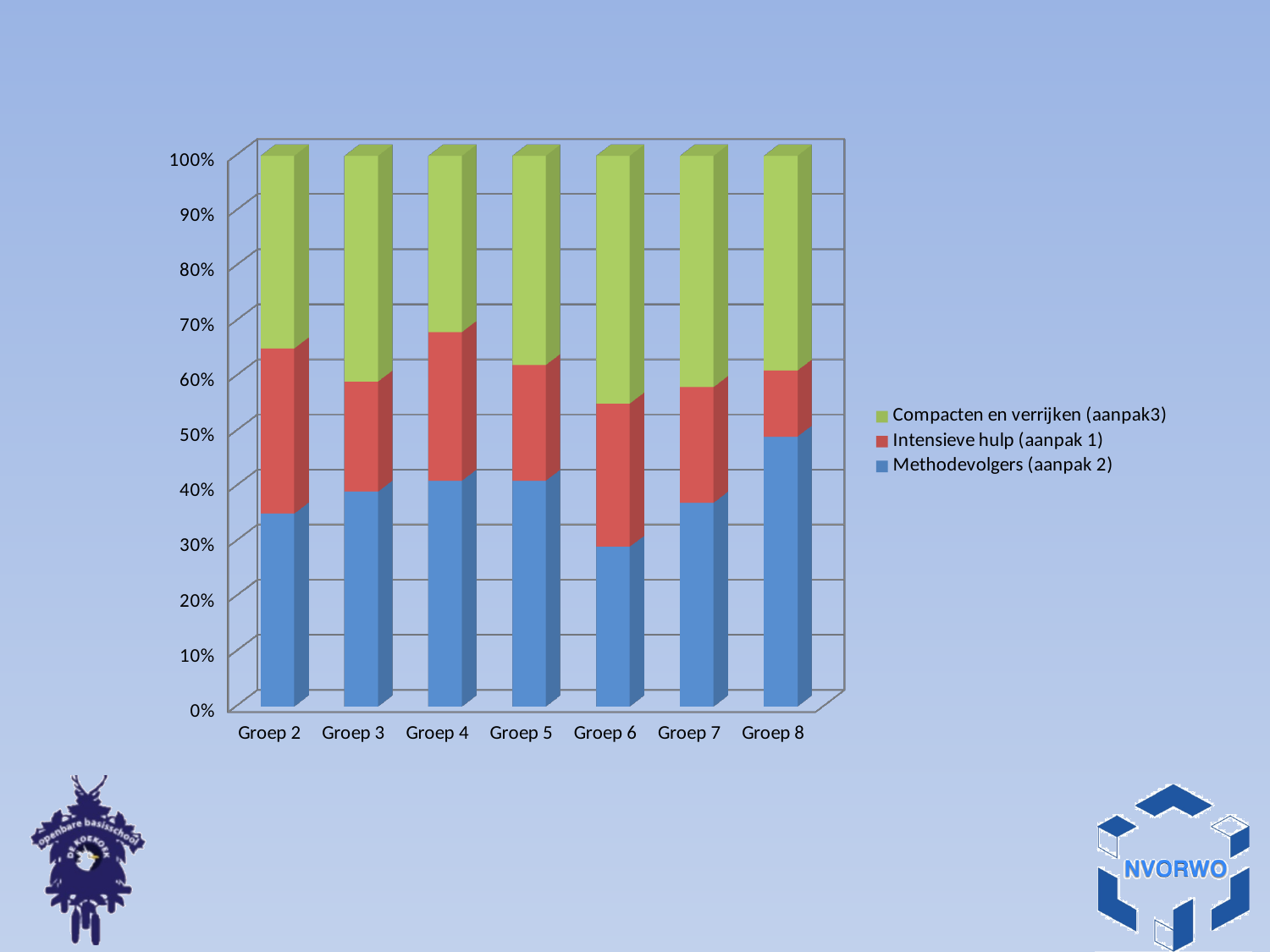
How many series does the legend list? 3 Which colour represents Methodevolgers (aanpak 2)? Blue Which group has the largest share for Methodevolgers (aanpak 2)? Groep 8 Which is larger: the Methodevolgers (aanpak 2) share in Groep 4 or in Groep 6? Groep 4 What kind of chart is shown on the slide? Stacked bar chart Is the share for Methodevolgers (aanpak 2) in Groep 8 greater or less than 40%? greater Which legend entry is listed first? Compacten en verrijken (aanpak3) Is the share for Methodevolgers (aanpak 2) in Groep 6 greater or less than 40%? less How many groups (categories) are shown on the x axis? 7 Which group has the smallest share for Methodevolgers (aanpak 2)? Groep 6 What does each stacked bar total? 100% Is the share for Methodevolgers (aanpak 2) in Groep 2 greater or less than 40%? less